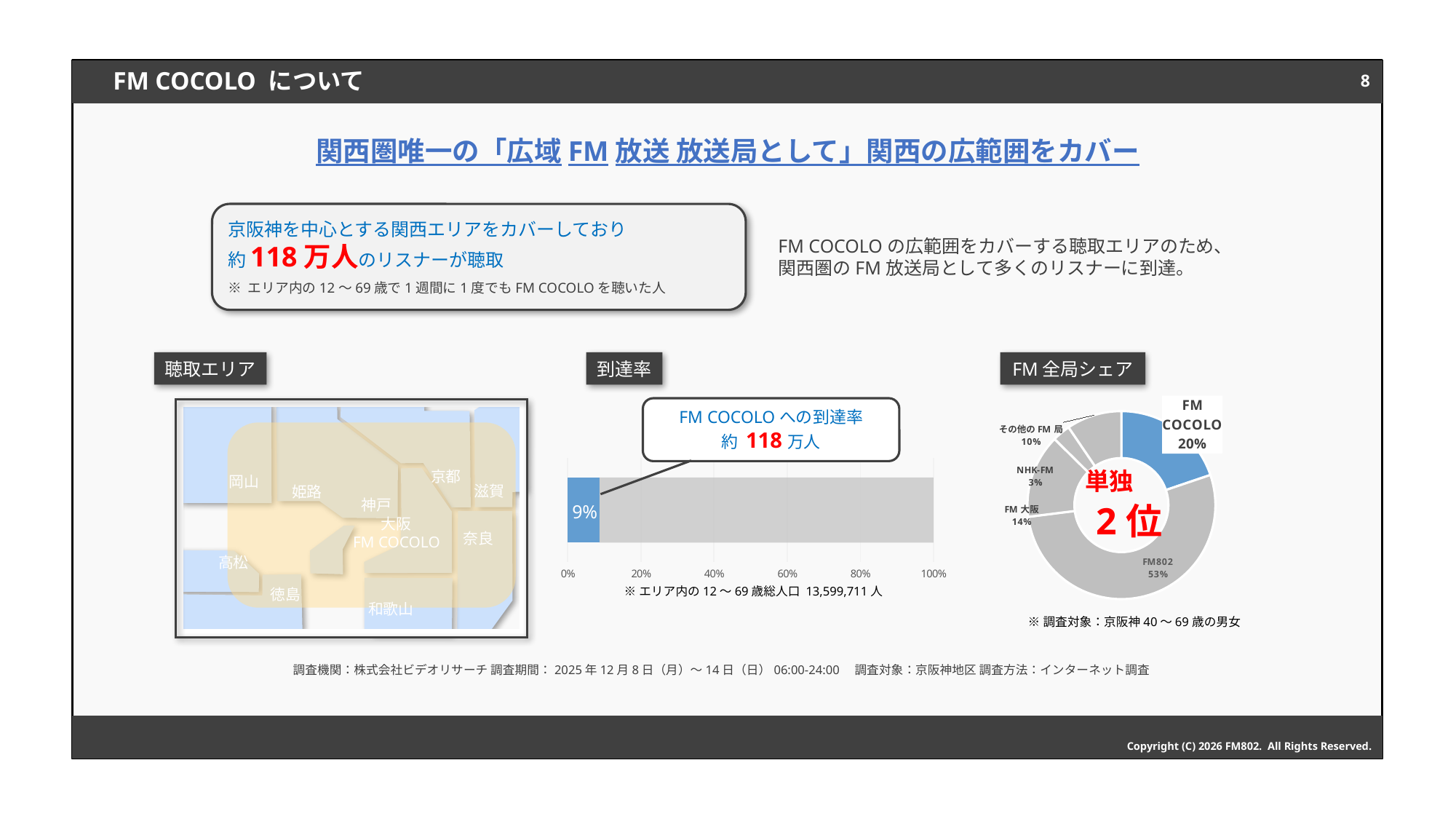
How many segments does the FM 全局シェア chart have? 5 In the 到達率 chart, what value is shown for the FM COCOLO reach rate? 9% In the FM 全局シェア chart, which station has the largest share? FM802 In the FM 全局シェア chart, what share does NHK-FM have? 3% In the FM 全局シェア chart, what share does FM COCOLO have? 20% In the FM 全局シェア chart, what is the difference between the shares of FM802 and FM COCOLO? 33% In the FM 全局シェア chart, what share does FM802 have? 53% What kind of chart is the 到達率 chart? Bar chart In the FM 全局シェア chart, which station has the smallest share? NHK-FM What kind of chart is the FM 全局シェア chart? Donut (pie) chart In the FM 全局シェア chart, what share does FM 大阪 have? 14% In the FM 全局シェア chart, which is larger, the share of FM COCOLO or the share of FM 大阪? FM COCOLO